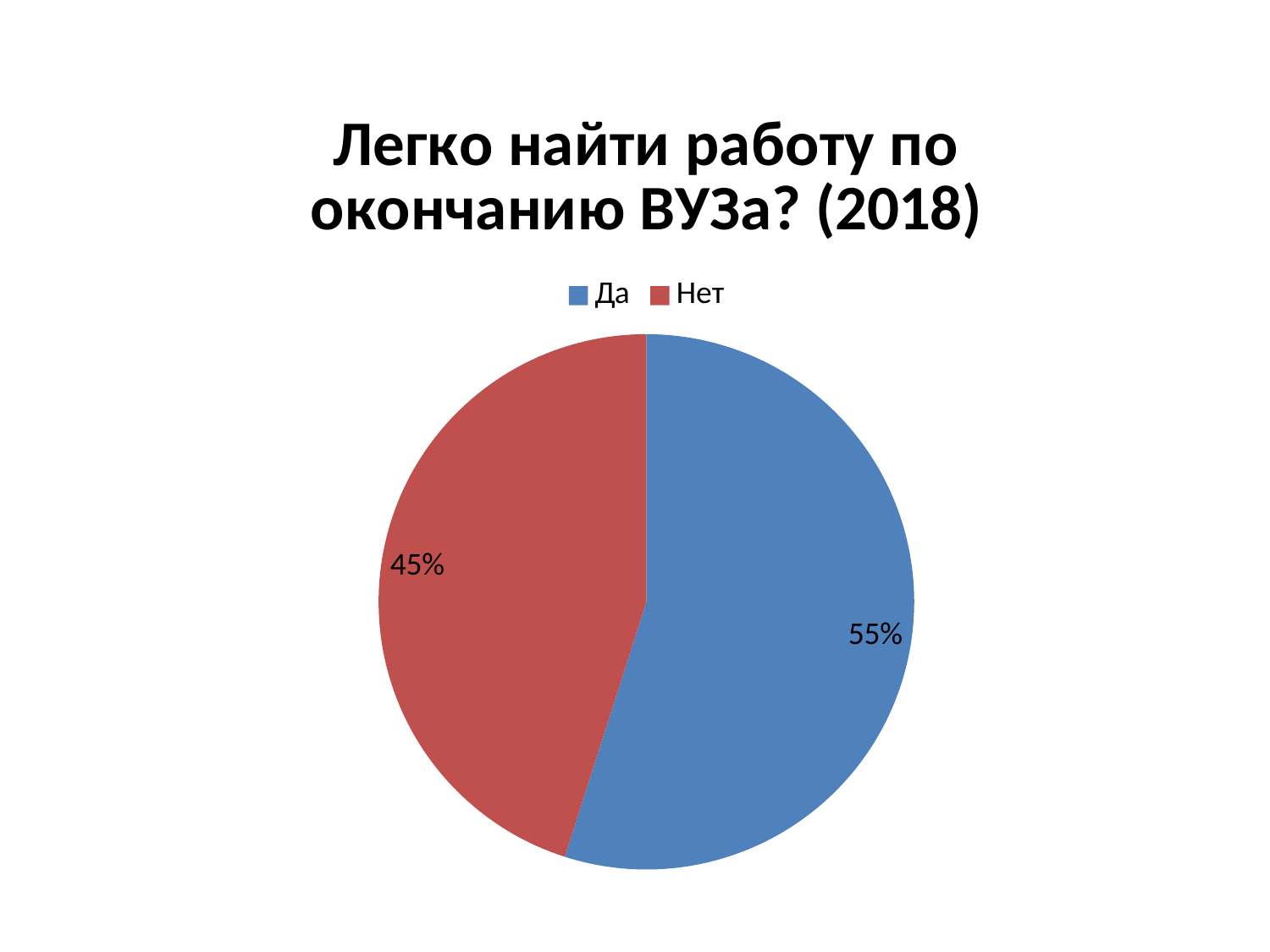
What share of the pie does the "Да" slice represent? 55% What colour is the "Нет" slice? Red Which is larger, the "Да" slice or the "Нет" slice? Да How many entries does the legend list? 2 What share of the pie does the "Нет" slice represent? 45% Which slice is the smallest in the pie chart? Нет Is the share for "Да" greater or less than 50%? greater Which slice is the largest in the pie chart? Да What is the difference in percentage points between the "Да" and "Нет" slices? 10% What kind of chart is shown on the slide? Pie chart How many slices does the pie chart have? 2 What is the title of the chart? Легко найти работу по окончанию ВУЗа? (2018)